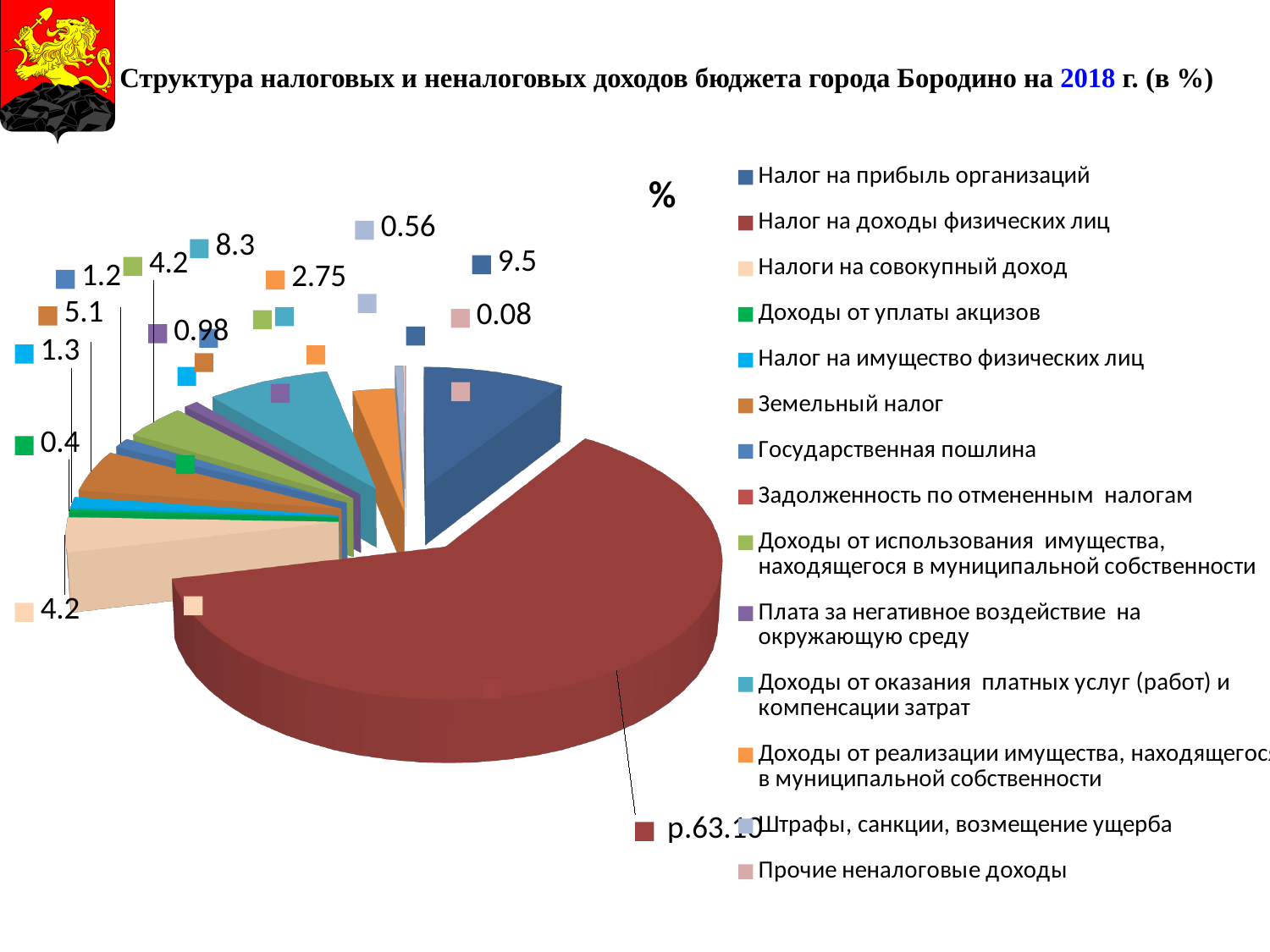
What is the value for Земельный налог? 5.1 What is the value for Прочие неналоговые доходы? 0.08 What is the value for Плата за негативное воздействие на окружающую среду? 0.98 What type of chart is shown on the slide? pie chart What is the difference between the values for Налог на прибыль организаций and Доходы от оказания платных услуг (работ) и компенсации затрат? 1.2 What is the value for Доходы от реализации имущества, находящегося в муниципальной собственности? 2.75 Which category has the largest slice of the pie? Налог на доходы физических лиц What is the title shown above the pie chart? % What is the value for Доходы от оказания платных услуг (работ) и компенсации затрат? 8.3 How many categories does the legend list? 14 Which is larger, Налог на прибыль организаций or Доходы от оказания платных услуг (работ) и компенсации затрат? Налог на прибыль организаций What is the value for Налог на прибыль организаций? 9.5